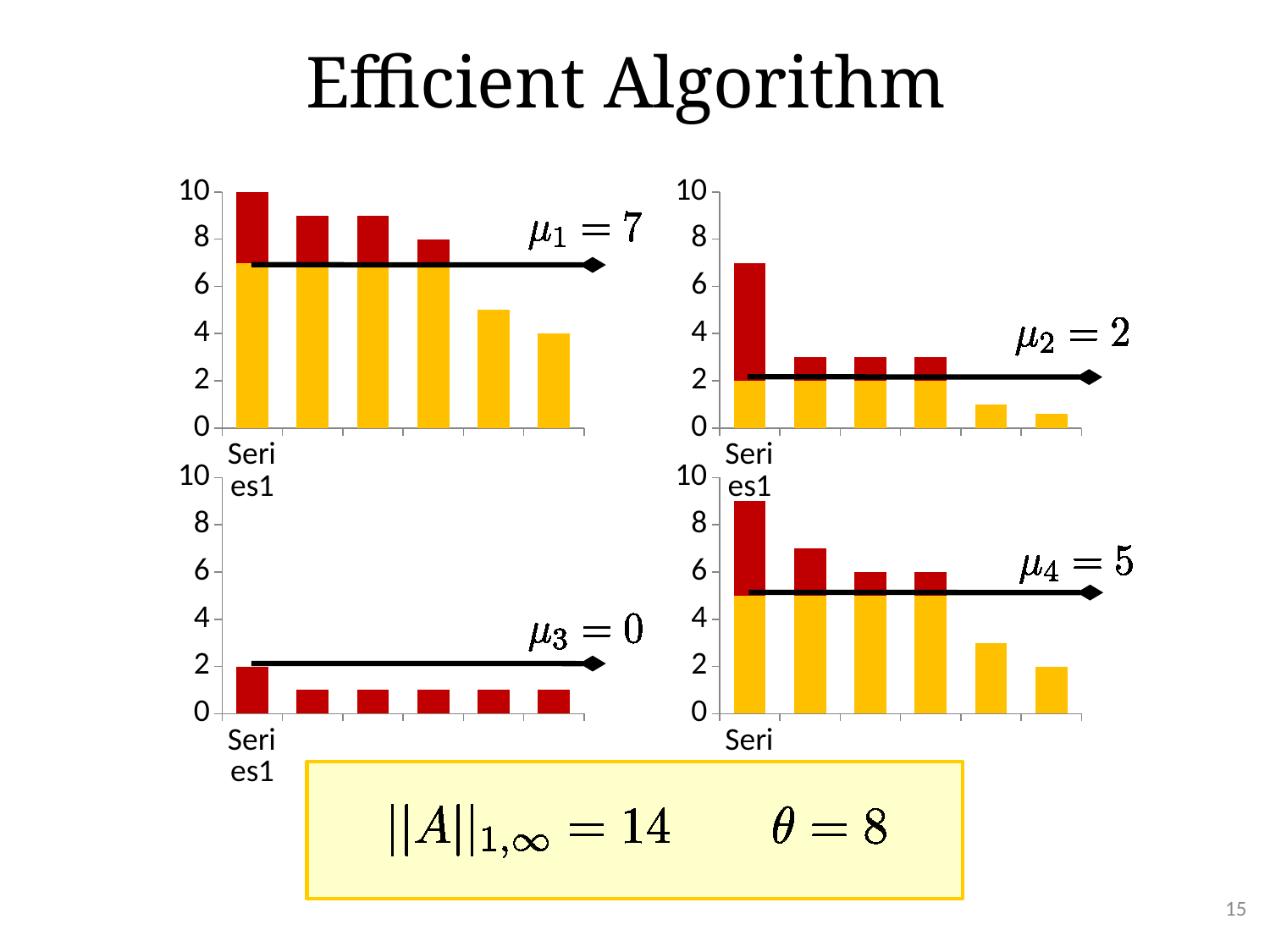
In the top-right chart, is the leftmost bar greater or less than 6? greater What two colours are used for the bars in the charts? red and yellow In the bottom-right chart, what value does the rightmost bar reach on the axis? 2 In the bottom-left chart, is the tallest bar greater or less than 4? less In the top-left chart, do the bar heights rise or fall from left to right? fall What value is given for μ1 next to the horizontal line in the top-left chart? 7 How many bars are plotted in the bottom-right chart? 6 In the top-left chart, what value does the tallest (leftmost) bar reach on the axis? 10 How many bars are plotted in the top-left chart? 6 In the bottom-right chart, which bar is the tallest? the leftmost bar In the top-left chart, what value does the rightmost bar reach on the axis? 4 What kind of chart is the top-left chart on the slide? bar chart